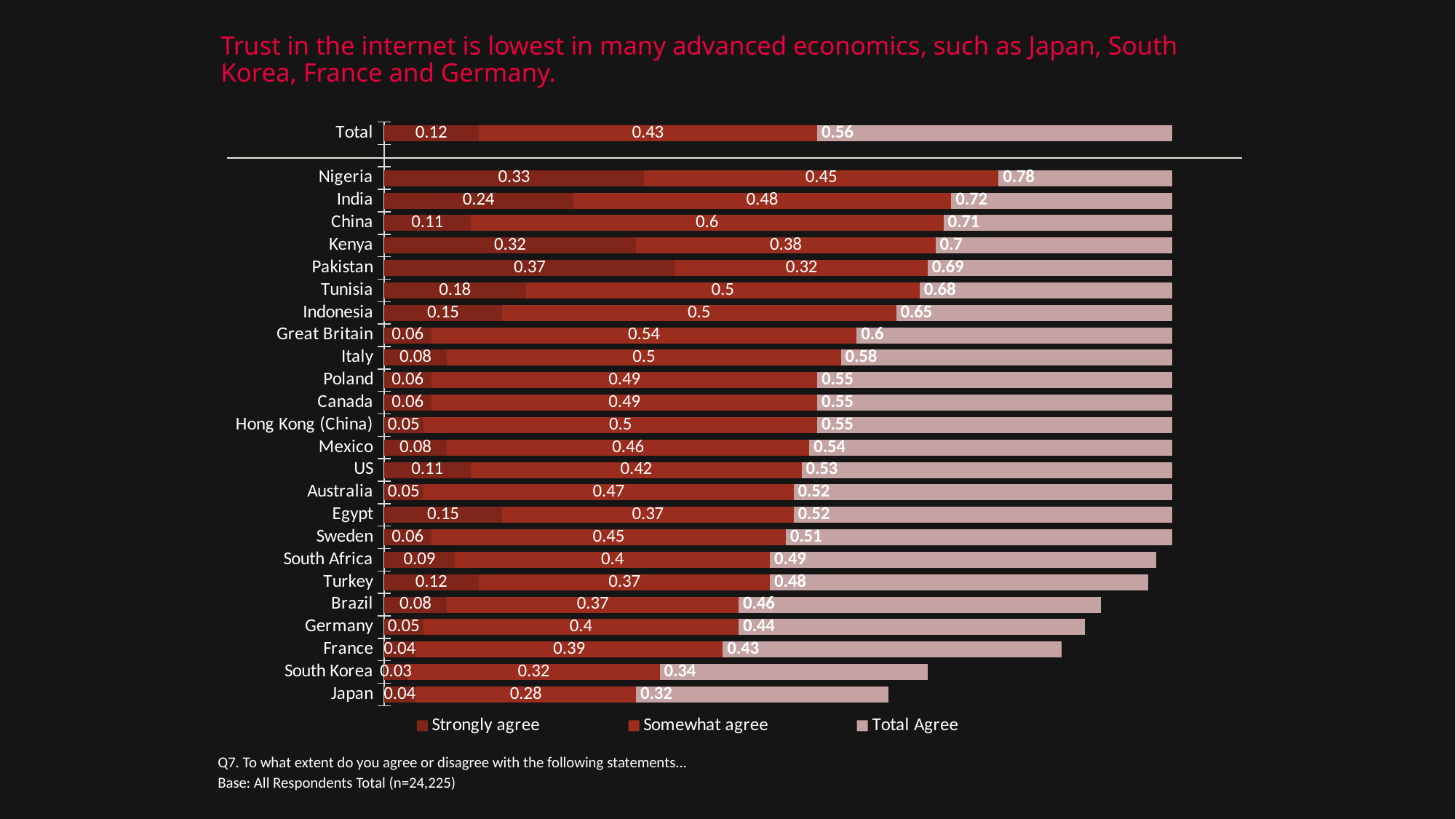
How many countries (excluding the Total row) are shown in the chart? 24 What is the Total Agree value for the Total row? 0.56 What kind of chart is shown on the slide? Bar chart Which country has the highest Strongly agree value? Pakistan How many series does the legend list? 3 What is the Total Agree value for Japan? 0.32 What is the difference between the Total Agree values for Nigeria and Japan? 0.46 What is the Strongly agree value for Nigeria? 0.33 Which has a larger Strongly agree value, Pakistan or Kenya? Pakistan Which country has the highest Total Agree value? Nigeria Which country has the lowest Total Agree value? Japan What is the Somewhat agree value for China? 0.6